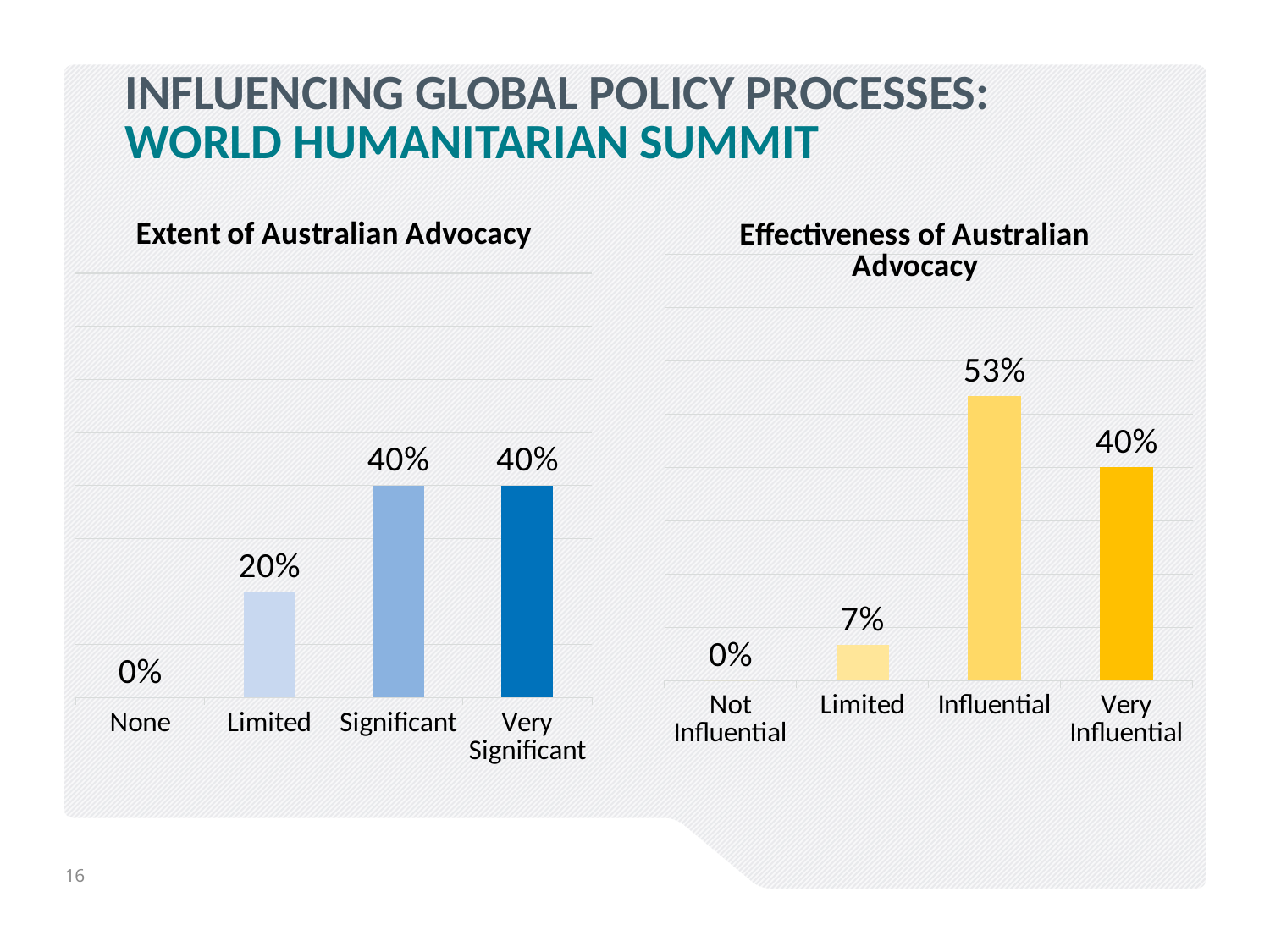
In the 'Effectiveness of Australian Advocacy' chart, which category has the highest value? Influential In the 'Effectiveness of Australian Advocacy' chart, what is the value for Limited? 7% In the 'Extent of Australian Advocacy' chart, what is the value for Limited? 20% What kind of chart is the 'Effectiveness of Australian Advocacy' chart? Bar chart In the 'Effectiveness of Australian Advocacy' chart, which is larger, Limited or Very Influential? Very Influential How many categories are shown in the 'Extent of Australian Advocacy' chart? 4 In the 'Effectiveness of Australian Advocacy' chart, what is the difference between Influential and Very Influential? 13% In the 'Extent of Australian Advocacy' chart, what is the difference between Significant and Limited? 20% In the 'Effectiveness of Australian Advocacy' chart, what is the value for Influential? 53% In the 'Extent of Australian Advocacy' chart, what is the value for None? 0% In the 'Extent of Australian Advocacy' chart, which category has the lowest value? None In the 'Extent of Australian Advocacy' chart, do the values rise or fall from None to Significant? Rise